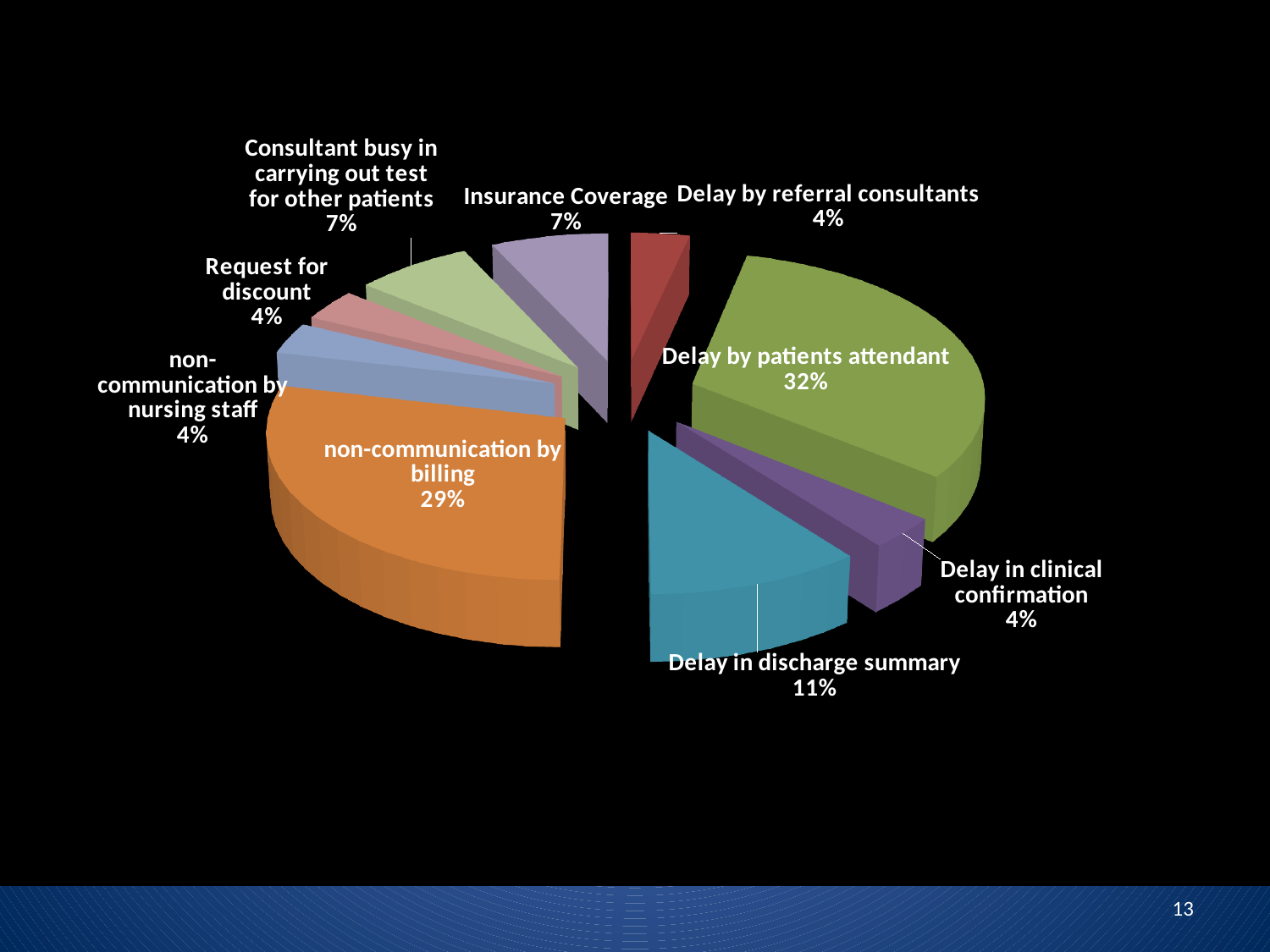
What colour is the slice for non-communication by billing? Orange What share of the pie is labelled for Delay in clinical confirmation? 4% What is the difference in percentage points between non-communication by billing and Delay in discharge summary? 18% Which is larger, the slice for Delay in discharge summary or the slice for Consultant busy in carrying out test for other patients? Delay in discharge summary What kind of chart is shown on the slide? Pie chart What share of the pie is labelled for Insurance Coverage? 7% What is the difference in percentage points between Delay by patients attendant and non-communication by billing? 3% How many slices does the pie chart have? 9 Which category has the largest slice of the pie? Delay by patients attendant What share of the pie is labelled for Delay by patients attendant? 32%